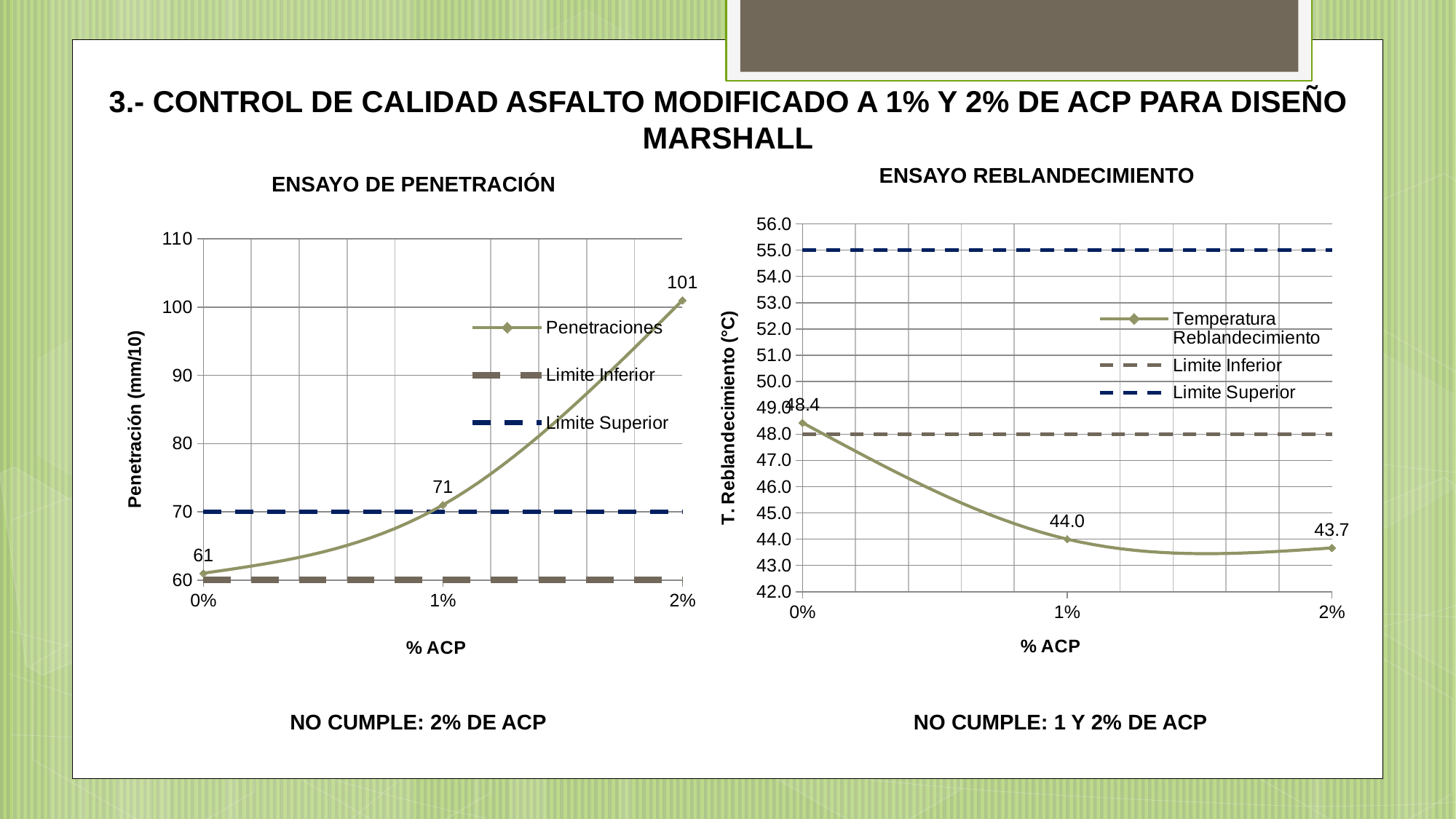
In the ENSAYO REBLANDECIMIENTO chart, what is the softening temperature at 2% ACP? 43.7 In the ENSAYO DE PENETRACIÓN chart, how many series does the legend list? 3 In the ENSAYO DE PENETRACIÓN chart, what is the difference between the penetration at 2% ACP and at 0% ACP? 40 In the ENSAYO DE PENETRACIÓN chart, what is the penetration value at 1% ACP? 71 In the ENSAYO REBLANDECIMIENTO chart, at which % ACP is the softening temperature highest? 0% In the ENSAYO REBLANDECIMIENTO chart, at what value does the Limite Superior line sit on the y axis? 55.0 What kind of chart is the ENSAYO REBLANDECIMIENTO chart? line chart In the ENSAYO DE PENETRACIÓN chart, at which % ACP is the penetration lowest? 0% In the ENSAYO DE PENETRACIÓN chart, do the penetration values rise or fall as % ACP increases? rise In the ENSAYO REBLANDECIMIENTO chart, what is the softening temperature at 0% ACP? 48.4 In the ENSAYO REBLANDECIMIENTO chart, what is the difference between the softening temperature at 0% ACP and at 1% ACP? 4.4 In the ENSAYO DE PENETRACIÓN chart, what is the penetration value at 2% ACP? 101